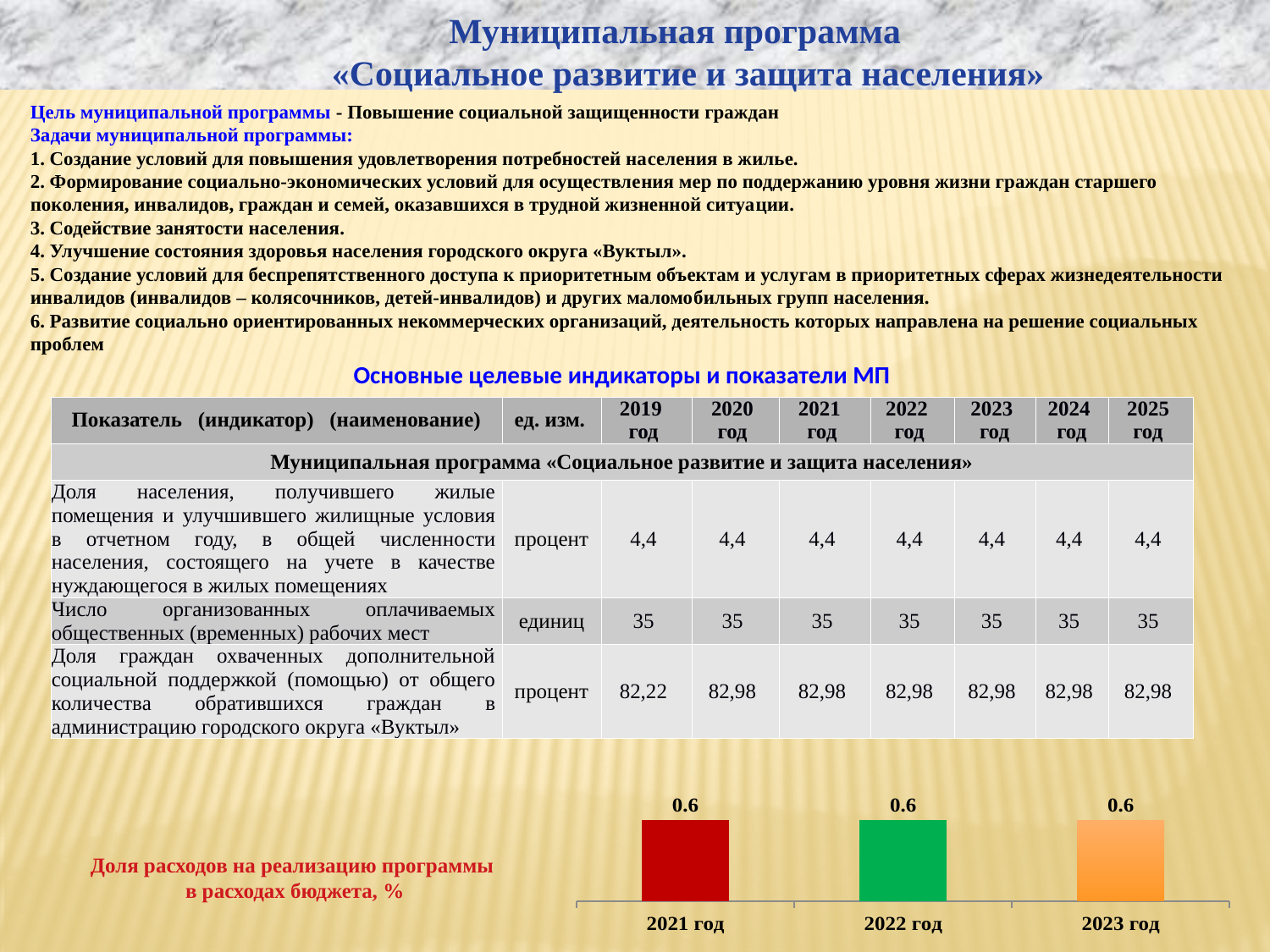
In the bar chart at the bottom of the slide, what is the value for 2022 год? 0.6 What colour is the bar for 2021 год in the chart at the bottom of the slide? red In the bar chart at the bottom of the slide, what is the difference between the values for 2021 год and 2023 год? 0 In the bar chart at the bottom of the slide, do the values rise, fall or stay the same from 2021 год to 2023 год? stay the same In the bar chart at the bottom of the slide, is the value for 2022 год greater or less than 1? less In the bar chart at the bottom of the slide, what is the value for 2021 год? 0.6 What is the label of the chart at the bottom of the slide? Доля расходов на реализацию программы в расходах бюджета, % In the bar chart at the bottom of the slide, what is the value for 2023 год? 0.6 How many bars are plotted in the chart at the bottom of the slide? 3 What type of chart is shown at the bottom of the slide? bar chart